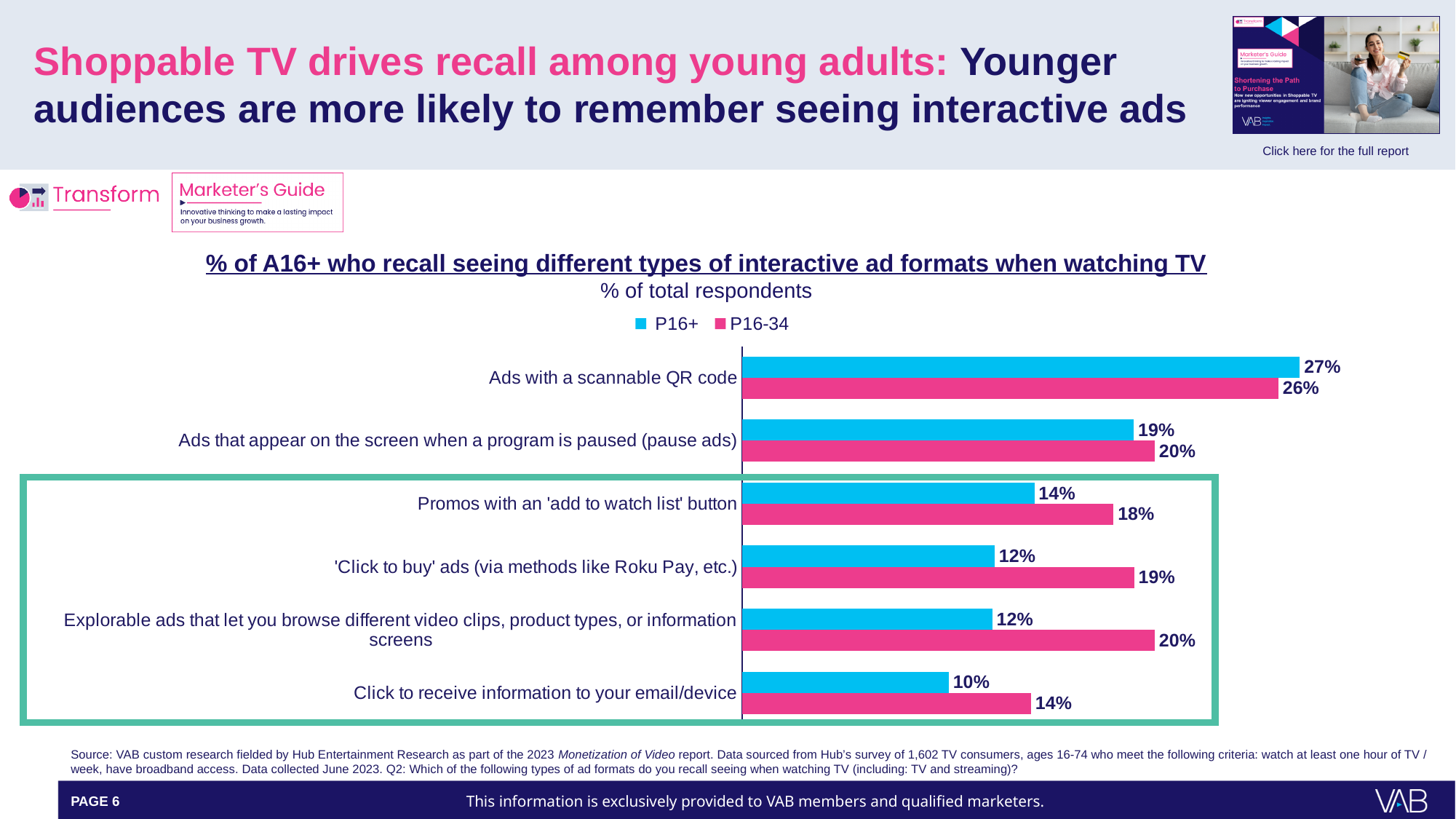
Which colour represents the P16-34 series in the chart? Pink How many ad format categories are shown in the chart? 6 What percentage of P16+ recall seeing ads with a scannable QR code? 27% What type of chart is shown on the slide? Bar chart What percentage of P16-34 recall seeing 'Click to buy' ads (via methods like Roku Pay, etc.)? 19% Which ad format has the lowest recall among P16-34? Click to receive information to your email/device What is the difference between the P16-34 and P16+ values for 'Click to buy' ads? 7 percentage points What is the difference between the P16+ and P16-34 values for ads with a scannable QR code? 1 percentage point How many series does the legend list? 2 What is the P16-34 value for 'Click to receive information to your email/device'? 14% For 'Promos with an add to watch list button', which group has the higher recall, P16+ or P16-34? P16-34 Which ad format has the highest recall among P16+? Ads with a scannable QR code